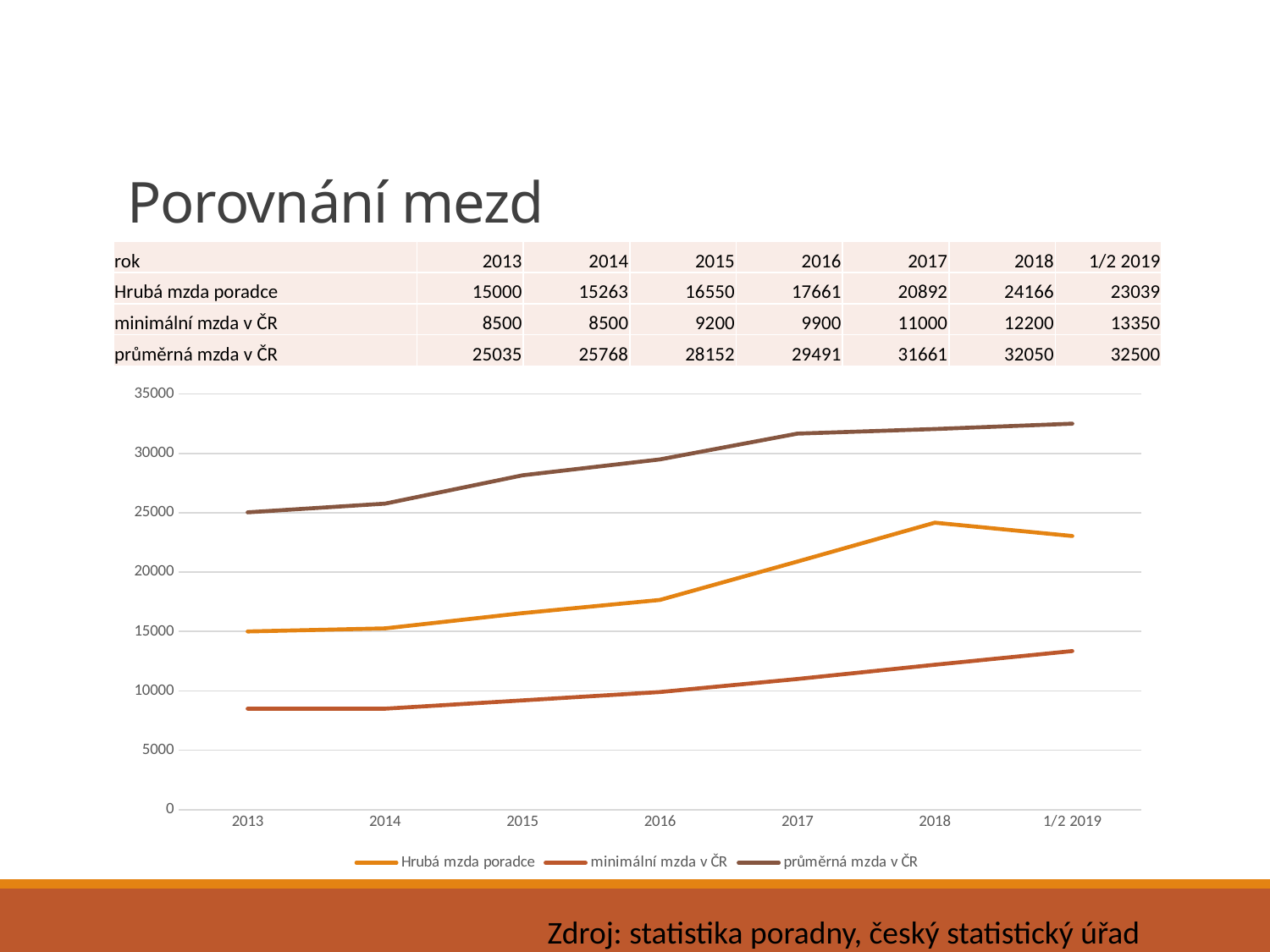
What is the value of průměrná mzda v ČR in 1/2 2019? 32500 What is the title of the slide containing the chart? Porovnání mezd Which is larger in 2017: Hrubá mzda poradce or minimální mzda v ČR? Hrubá mzda poradce Does průměrná mzda v ČR rise or fall from 2013 to 2018? rise How many points along the x axis does each line have? 7 What kind of chart is shown on the slide? line chart How many series does the chart legend list? 3 In which year is minimální mzda v ČR lowest? 2013 and 2014 (both 8500) What is the value of minimální mzda v ČR in 2016? 9900 What is the value of Hrubá mzda poradce in 2018? 24166 In which year is Hrubá mzda poradce highest? 2018 What is the difference between průměrná mzda v ČR and Hrubá mzda poradce in 2013? 10035